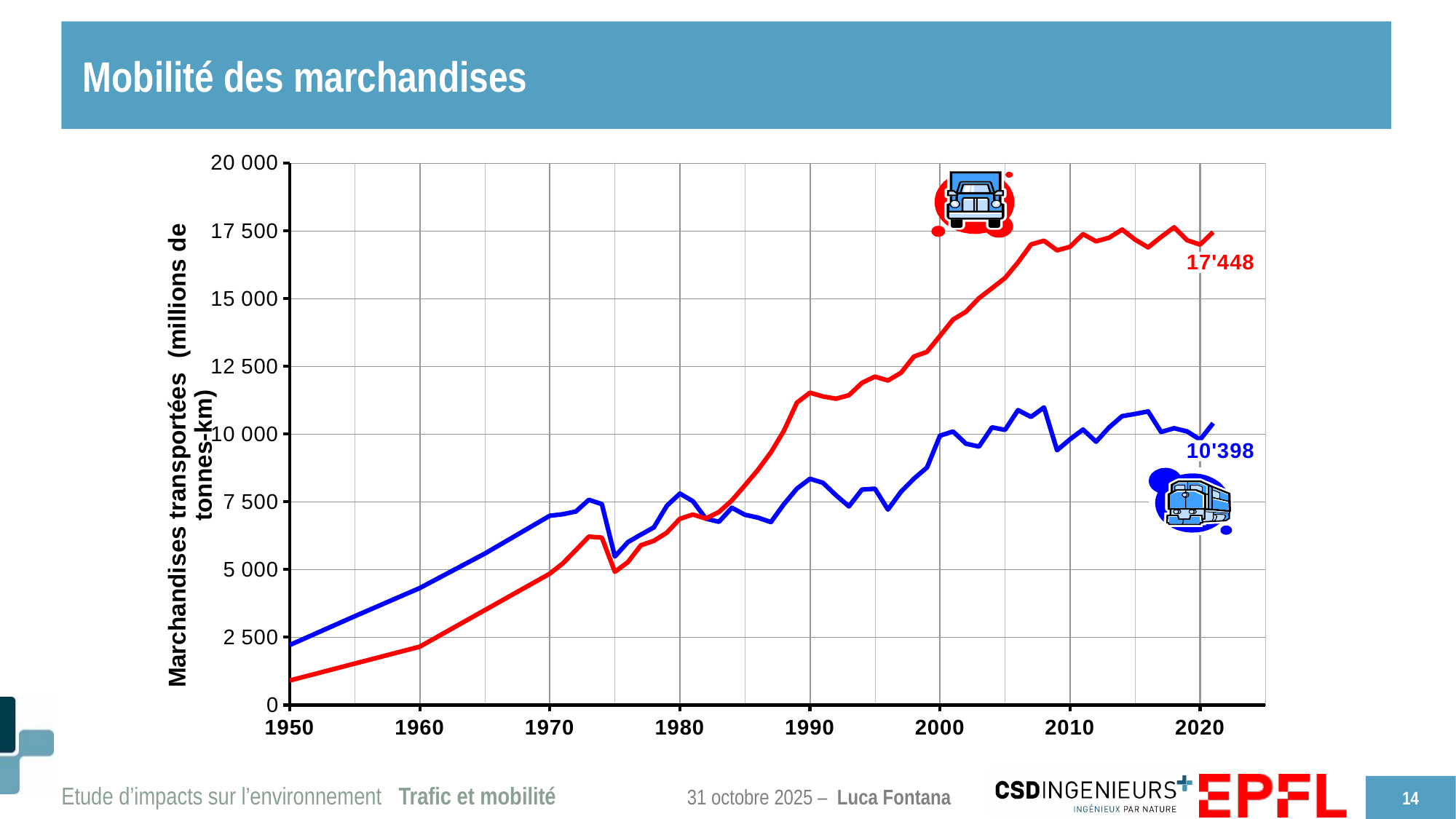
What is the label of the vertical axis of the chart? Marchandises transportées (millions de tonnes-km) Is the value of the red line in 1950 greater or less than 2 500? less What kind of chart is shown on the slide? line chart Is the value of the blue line in 1970 greater or less than 5 000? greater What is the title of the slide containing the chart? Mobilité des marchandises At the end of the series, which line has the higher value, the red line or the blue line? red line What is the final labelled value of the red line? 17'448 What is the final labelled value of the blue line? 10'398 Is the value of the red line in 1990 greater or less than 10 000? greater Overall, does the red line rise or fall from 1950 to 2020? rise How many lines are plotted on the chart? 2 What is the difference between the final labelled values of the red line and the blue line? 7'050